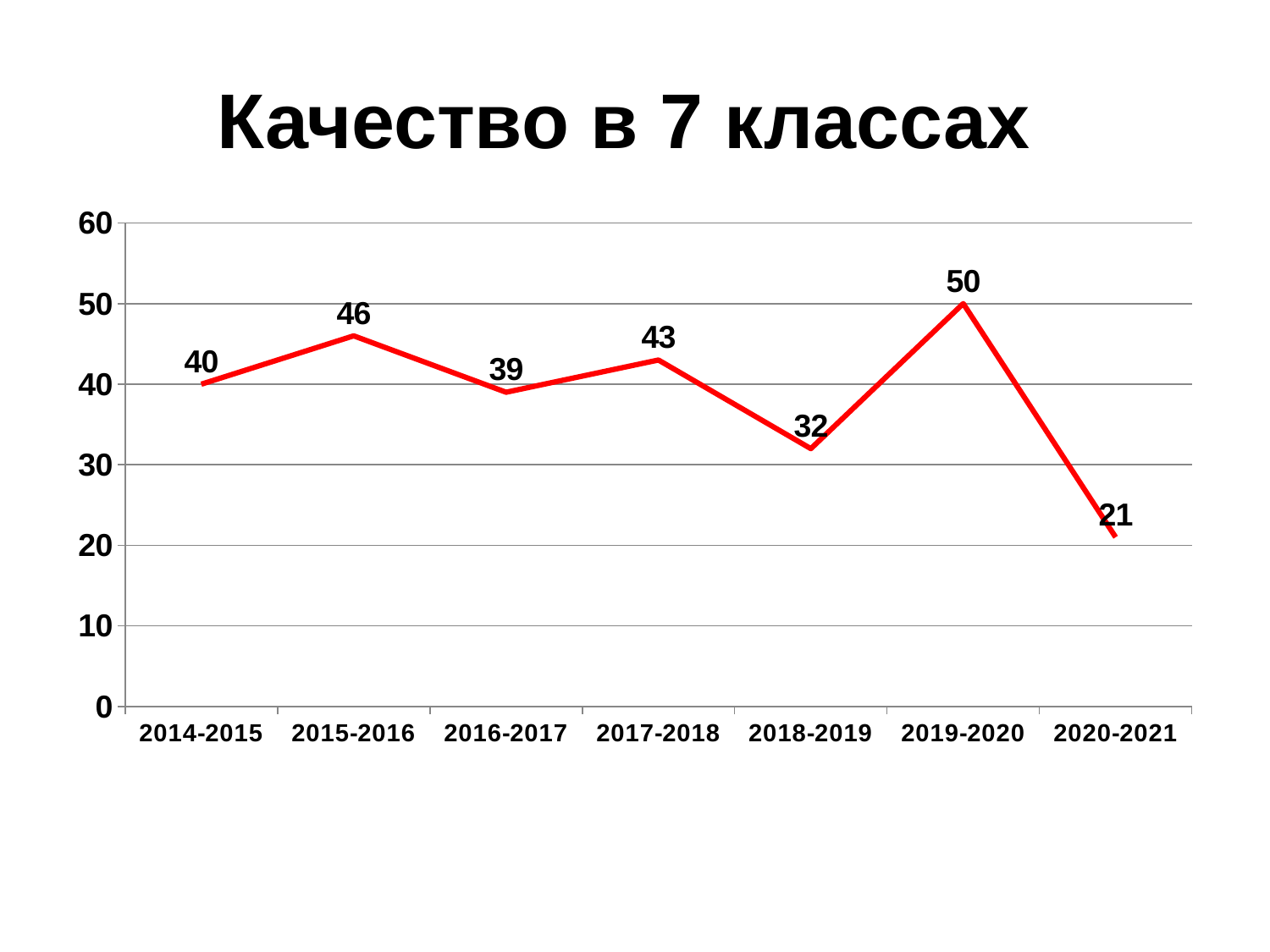
Which year has the lowest value? 2020-2021 What kind of chart is this? line chart How many years are shown on the x axis? 7 Which year has the highest value? 2019-2020 What is the title of the chart? Качество в 7 классах What is the value for 2019-2020? 50 What is the difference between the values for 2019-2020 and 2020-2021? 29 Which is larger, the value for 2017-2018 or the value for 2018-2019? 2017-2018 What is the value for 2014-2015? 40 What is the difference between the values for 2015-2016 and 2016-2017? 7 What is the value for 2020-2021? 21 Is the value for 2018-2019 greater or less than 40? less